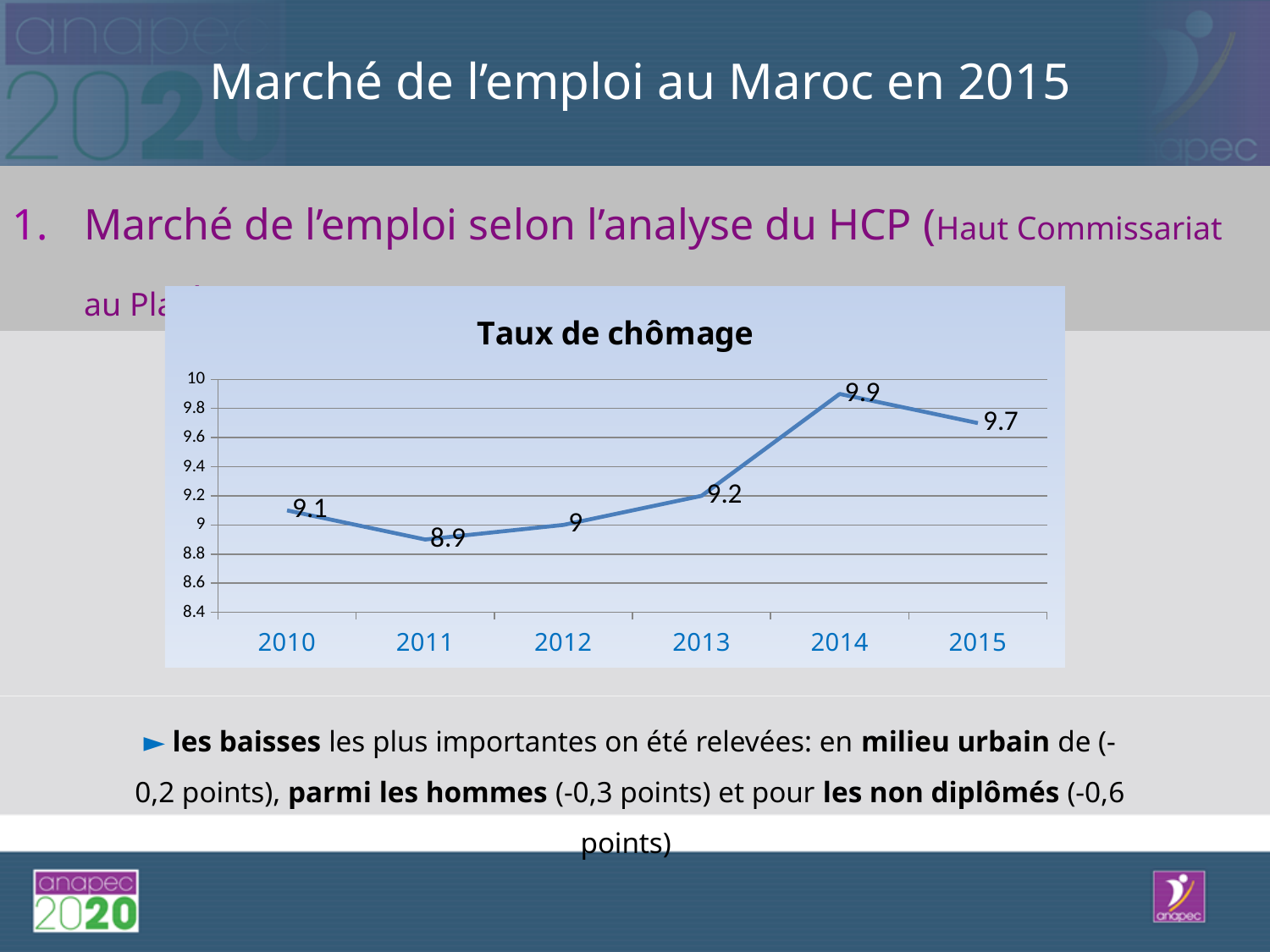
What is the title of the chart on the slide? Taux de chômage What is the unemployment rate (Taux de chômage) shown for 2014? 9.9 Which year has the lowest unemployment rate in the chart? 2011 What is the difference between the 2013 value and the 2012 value? 0.2 What is the value shown for 2015? 9.7 What is the value plotted for 2011 in the Taux de chômage chart? 8.9 What type of chart is used to show the Taux de chômage? Line chart Does the unemployment rate rise or fall from 2011 to 2014? Rise How many years are plotted on the x axis of the chart? 6 Which year has a higher value, 2010 or 2013? 2013 By how much did the unemployment rate change between 2014 and 2015? 0.2 Which year has the highest unemployment rate in the chart? 2014